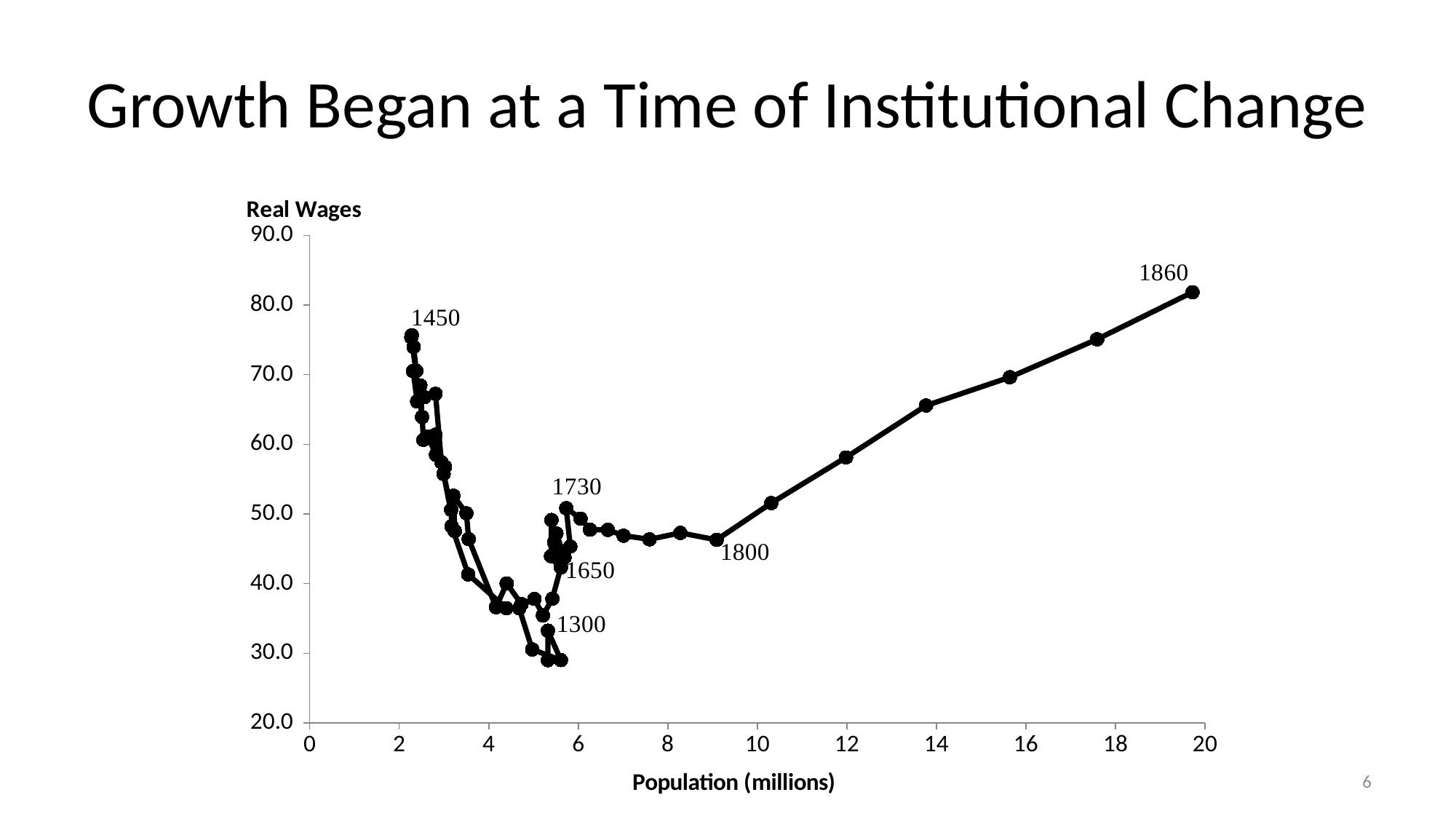
Which point has higher real wages, the one labeled 1860 or the one labeled 1450? 1860 Which point has higher real wages, the one labeled 1800 or the one labeled 1300? 1800 What kind of chart is shown on the slide? line chart Is the real wage value for the point labeled 1450 greater or less than 70.0? greater Is the real wage value for the point labeled 1300 greater or less than 40.0? less What is the title of the horizontal axis? Population (millions) Is the real wage value for the point labeled 1800 greater or less than 50.0? less Of the years labeled on the chart, which has the highest real wages? 1860 What is the title of the vertical axis? Real Wages How many year labels are printed on the chart? 6